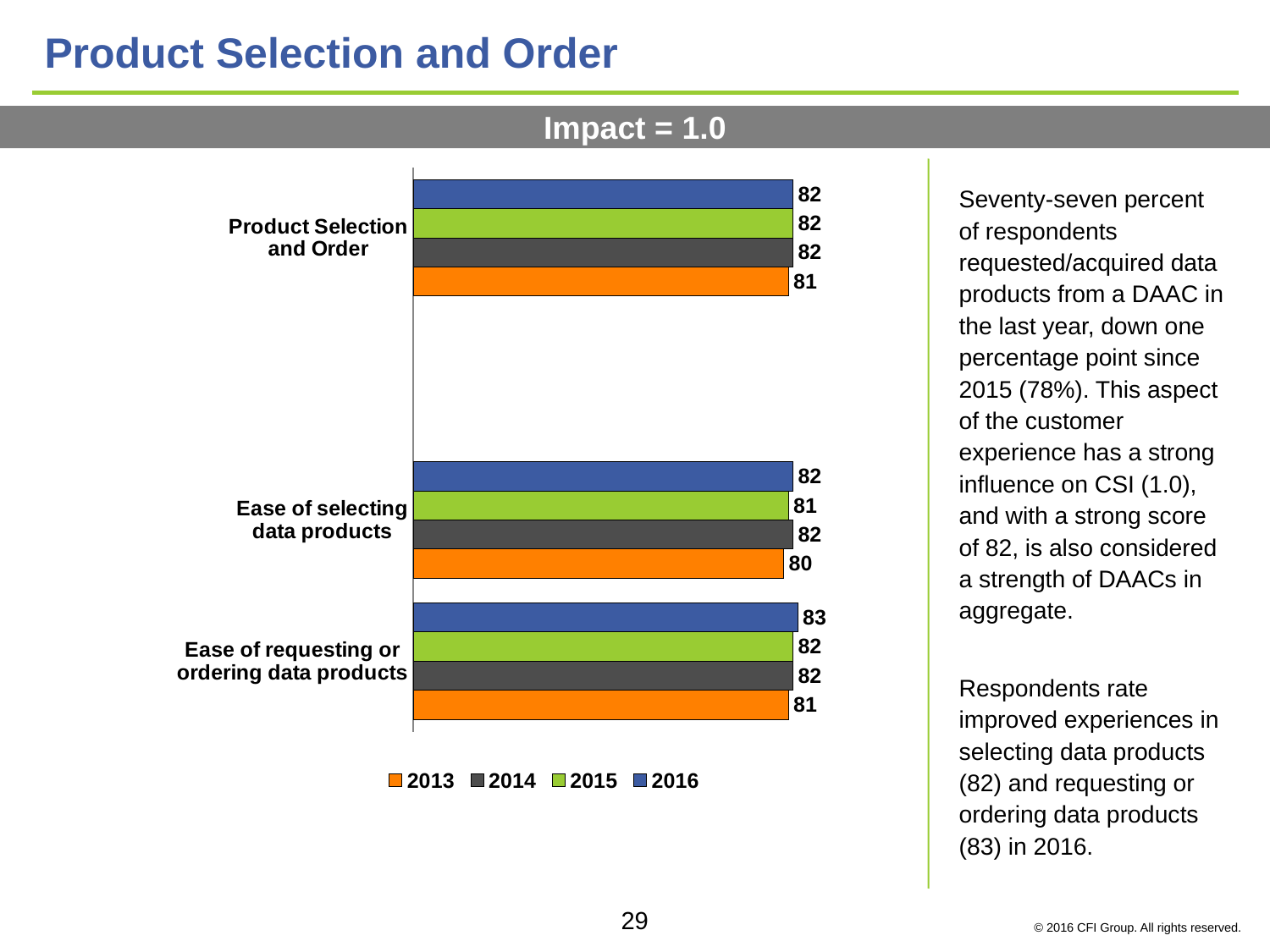
What kind of chart is shown on the slide? bar chart Which category has the highest 2016 value? Ease of requesting or ordering data products What is the 2013 value for Ease of selecting data products? 80 Which is larger for Ease of requesting or ordering data products: the 2016 value or the 2013 value? 2016 What is the 2015 value for Ease of selecting data products? 81 How many series does the legend list? 4 What is the difference between the 2016 and 2013 values for Ease of selecting data products? 2 What is the 2016 value for Ease of requesting or ordering data products? 83 Which year does the orange bar represent in the legend? 2013 What is the 2013 value for Product Selection and Order? 81 Which category has the lowest 2013 value? Ease of selecting data products How many categories are plotted on the chart? 3